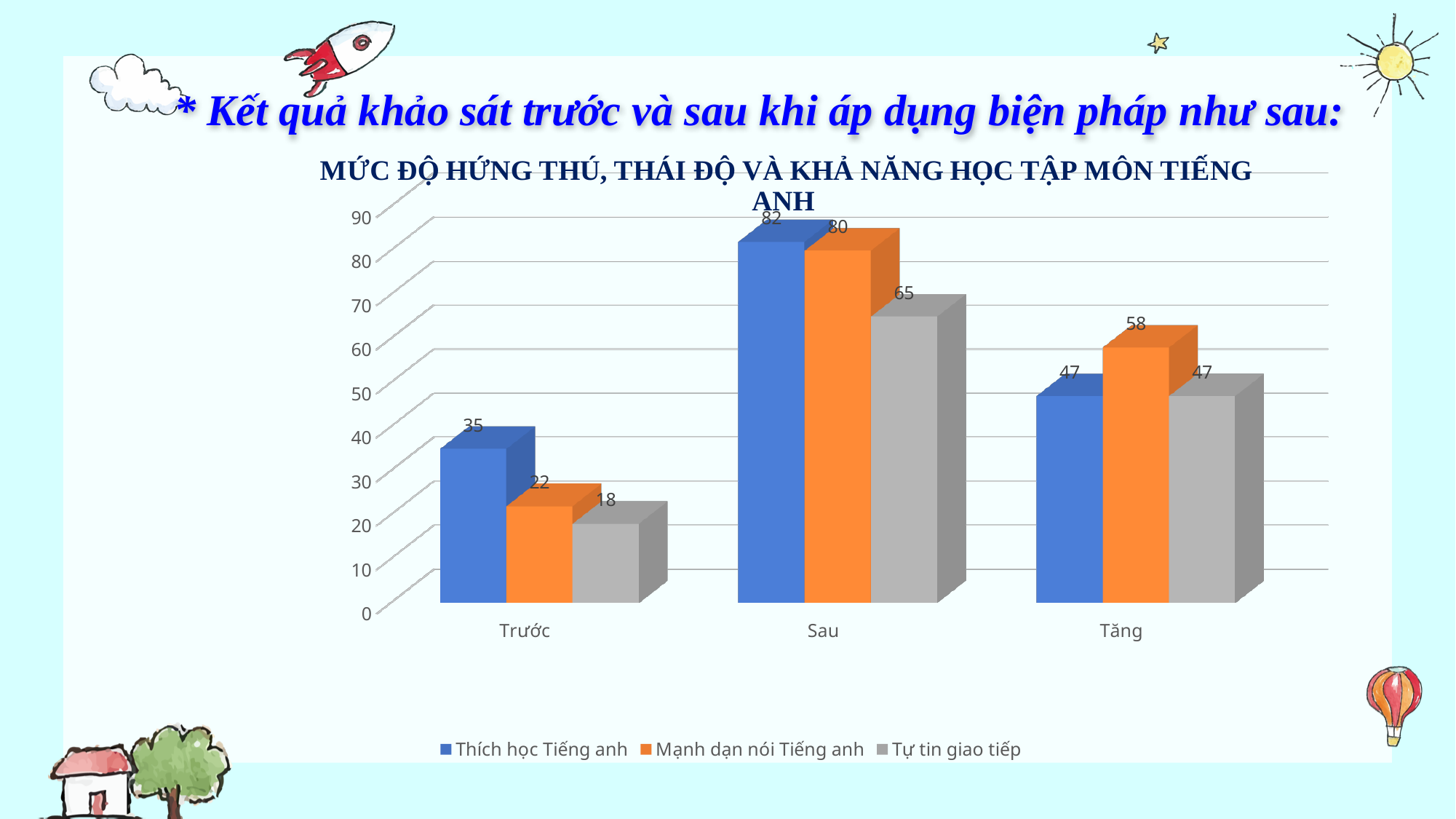
Which series has the lowest value in the "Trước" category? Tự tin giao tiếp How many series does the legend list? 3 What is the title of the chart? MỨC ĐỘ HỨNG THÚ, THÁI ĐỘ VÀ KHẢ NĂNG HỌC TẬP MÔN TIẾNG ANH What kind of chart is shown on the slide? Bar chart Which category has the highest value for "Tự tin giao tiếp"? Sau How many categories are shown on the x axis? 3 What is the value for "Tự tin giao tiếp" in the "Tăng" category? 47 What is the difference between the "Sau" and "Trước" values for "Thích học Tiếng anh"? 47 What is the value for "Mạnh dạn nói Tiếng anh" in the "Sau" category? 80 Which is larger in the "Tăng" category: "Mạnh dạn nói Tiếng anh" or "Thích học Tiếng anh"? Mạnh dạn nói Tiếng anh What is the value for "Thích học Tiếng anh" in the "Trước" category? 35 Which colour represents the "Mạnh dạn nói Tiếng anh" series? Orange